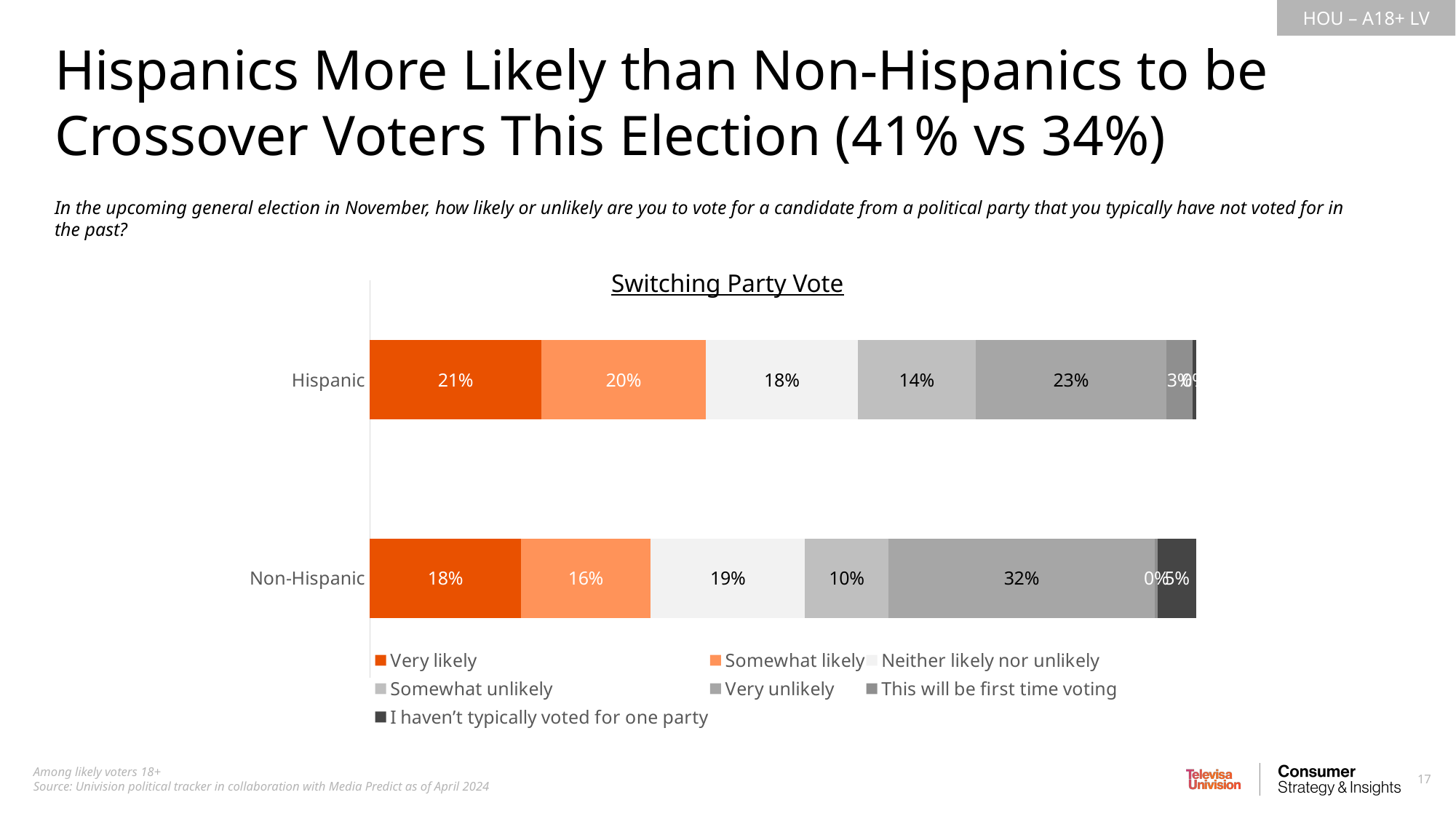
What percentage of Non-Hispanic respondents are 'Very unlikely' to switch their party vote? 32% What is the difference between the 'Somewhat unlikely' values for Hispanic and Non-Hispanic respondents? 4% How many categories (bars) are plotted in the chart? 2 What is the title of the chart? Switching Party Vote What percentage of Hispanic respondents are 'Very likely' to switch their party vote? 21% Which response category is the largest segment in the Non-Hispanic bar? Very unlikely Which group has the larger 'Very unlikely' share, Hispanic or Non-Hispanic? Non-Hispanic What is the difference between the 'Very likely' values for Hispanic and Non-Hispanic respondents? 3% How many series does the legend list? 7 What is the 'Somewhat likely' value for Non-Hispanic respondents? 16% What type of chart is shown on the slide? stacked bar chart What is the 'Somewhat unlikely' value for Hispanic respondents? 14%